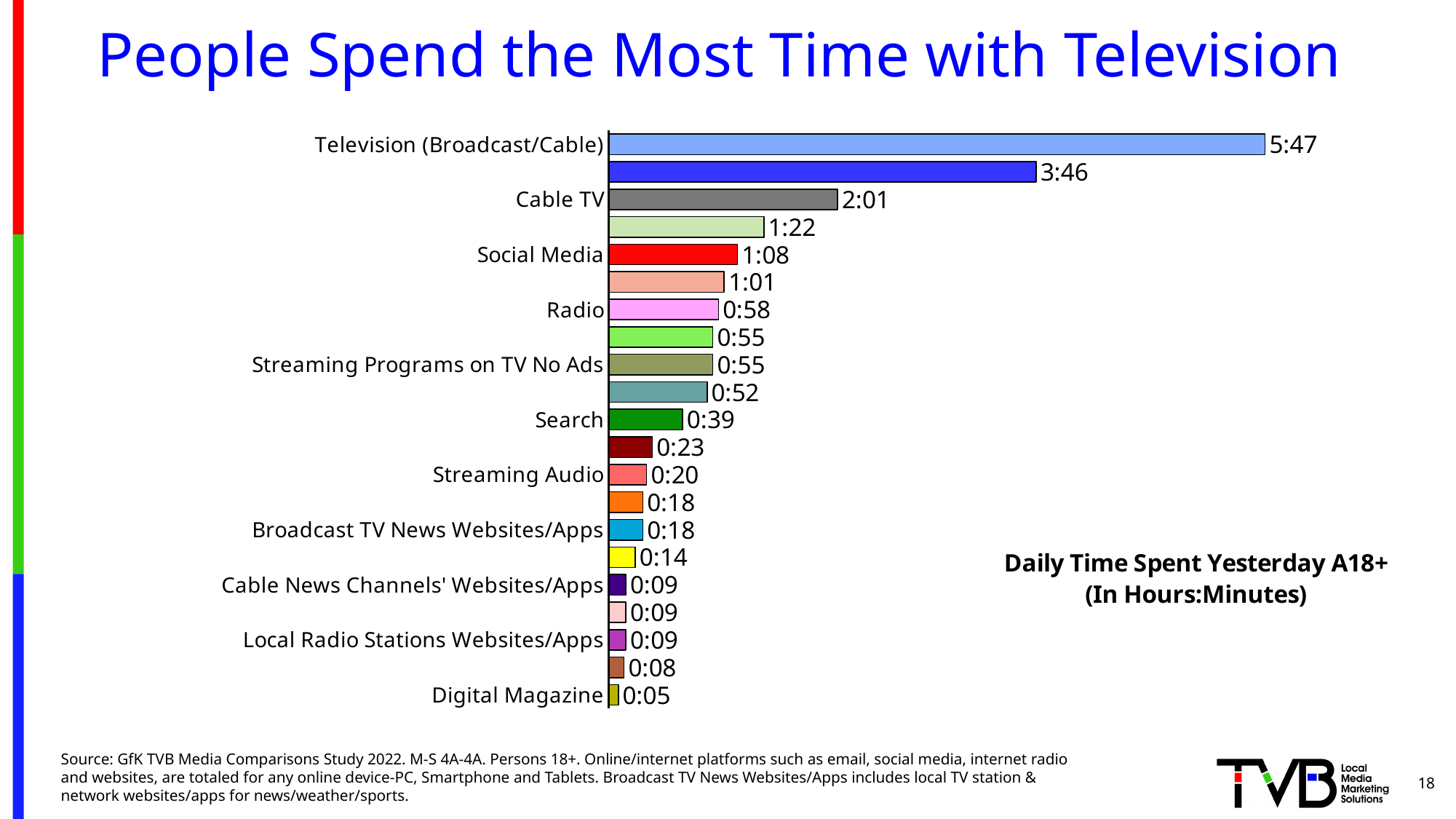
How many bars are plotted in the chart? 21 What is the daily time spent with Digital Magazine? 0:05 What is the daily time spent with Radio? 0:58 Which category has the highest daily time spent? Television (Broadcast/Cable) How much more daily time is spent with Television (Broadcast/Cable) than with Cable TV? 3:46 What is the daily time spent with Search? 0:39 Which has a higher daily time spent, Social Media or Radio? Social Media What is the daily time spent with Television (Broadcast/Cable)? 5:47 What is the daily time spent with Cable TV? 2:01 What type of chart is shown on the slide? bar chart Which category has the lowest daily time spent? Digital Magazine What is the daily time spent with Social Media? 1:08